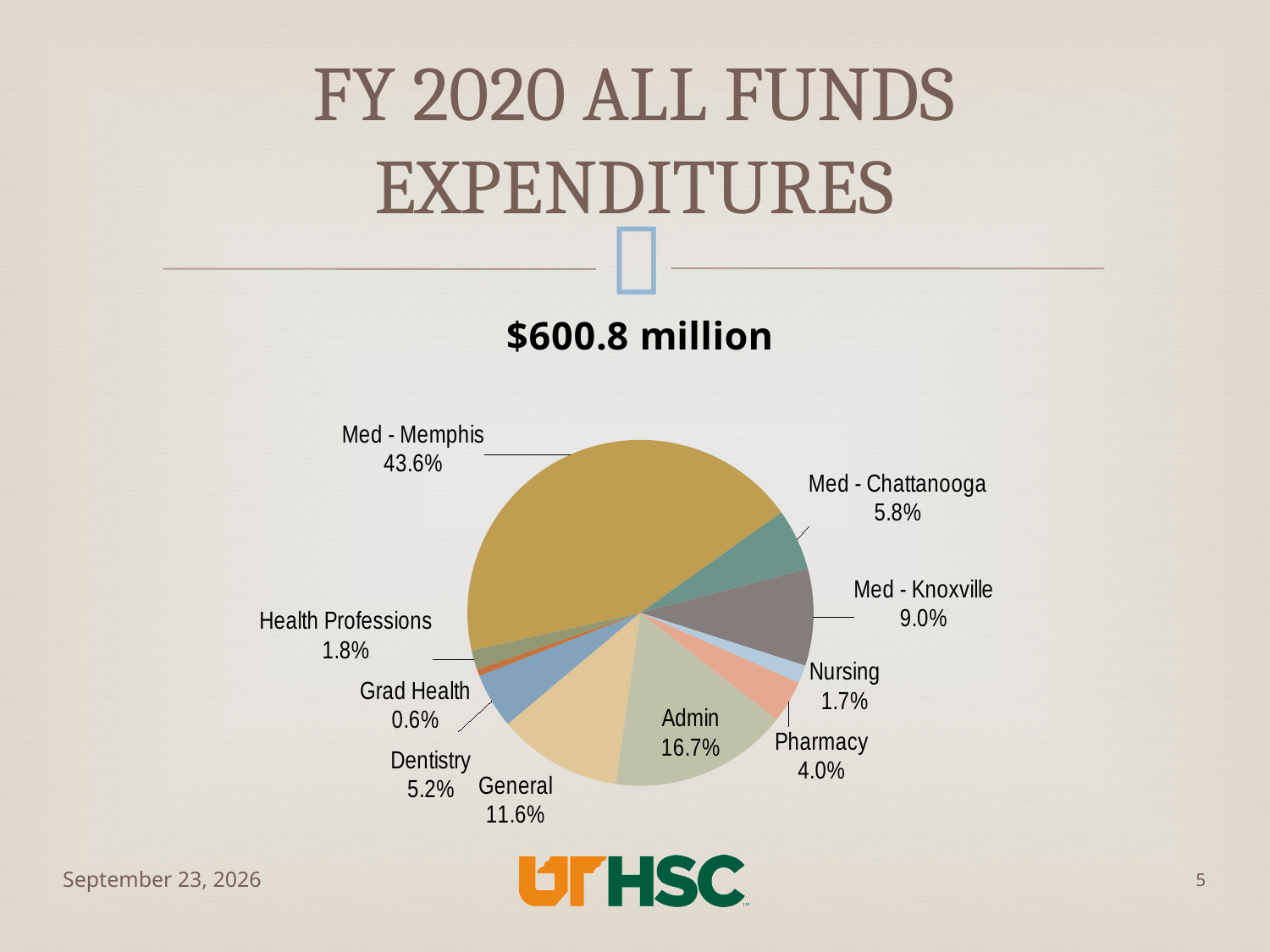
What is the percentage shown for Med - Knoxville? 9.0% What is the difference in percentage points between General and Dentistry? 6.4 Which category has the largest slice of the pie? Med - Memphis What is the percentage shown for Grad Health? 0.6% What total dollar amount is shown above the pie chart? $600.8 million What is the combined share of Nursing and Health Professions? 3.5% What share of expenditures does Med - Memphis account for? 43.6% What kind of chart is shown on the slide? pie chart Which is larger, the share for Med - Chattanooga or the share for Pharmacy? Med - Chattanooga Which category has the smallest slice of the pie? Grad Health What is the percentage shown for Admin? 16.7% How many slices does the pie chart have? 10